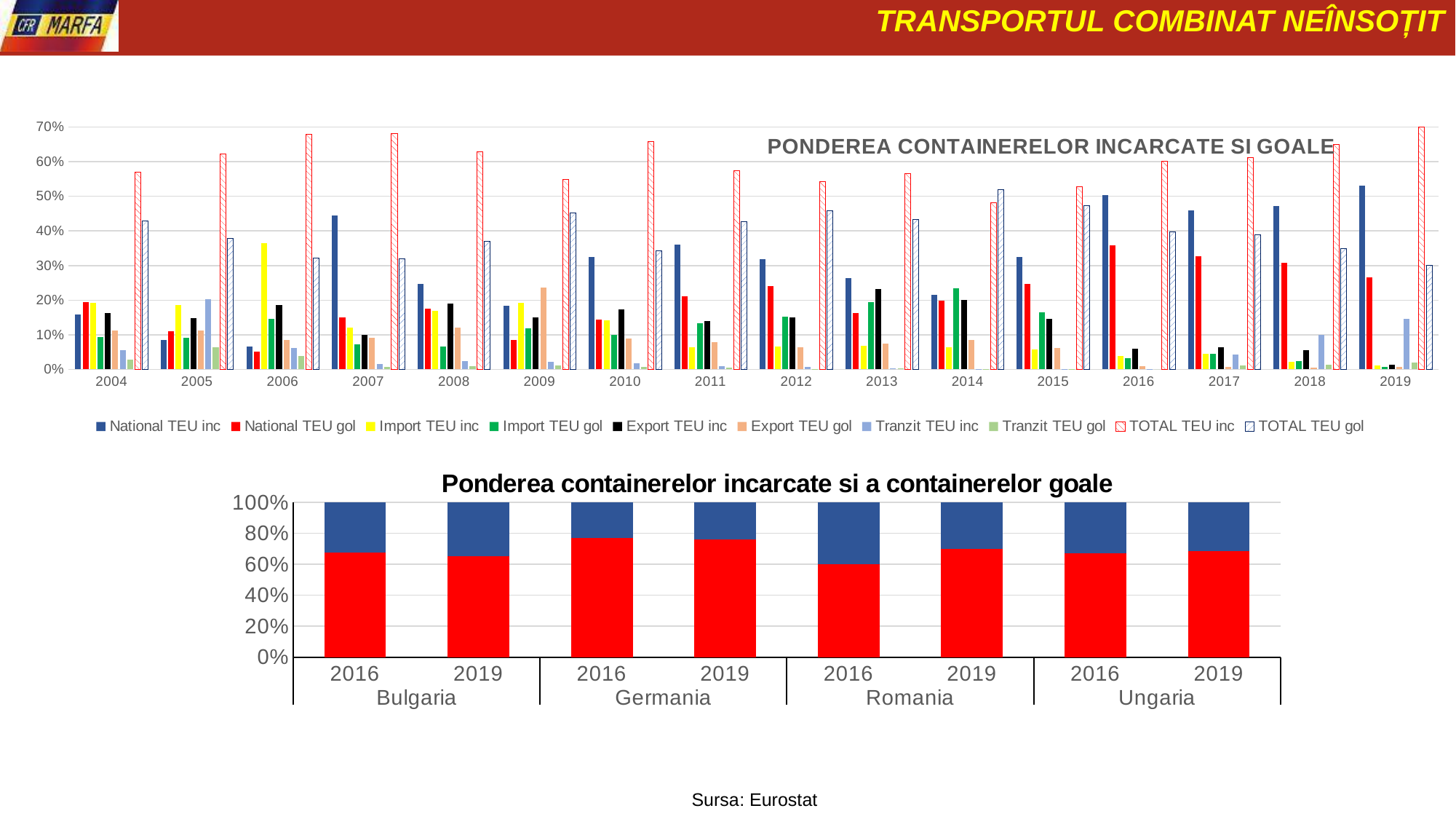
In the top chart, is the value for TOTAL TEU gol in 2007 greater or less than 40%? less What kind of chart is the top chart titled 'PONDEREA CONTAINERELOR INCARCATE SI GOALE'? bar chart In the bottom chart, is the red segment for Romania in 2016 greater or less than 80%? less In the top chart, is the value for Export TEU gol in 2009 greater or less than 20%? greater How many countries are shown on the x axis of the bottom chart? 4 In the bottom chart, is the red segment for Germania in 2016 larger or smaller than the red segment for Romania in 2016? larger What kind of chart is the bottom chart titled 'Ponderea containerelor incarcate si a containerelor goale'? stacked bar chart How many years are shown on the x axis of the top chart? 16 How many series does the legend of the top chart list? 10